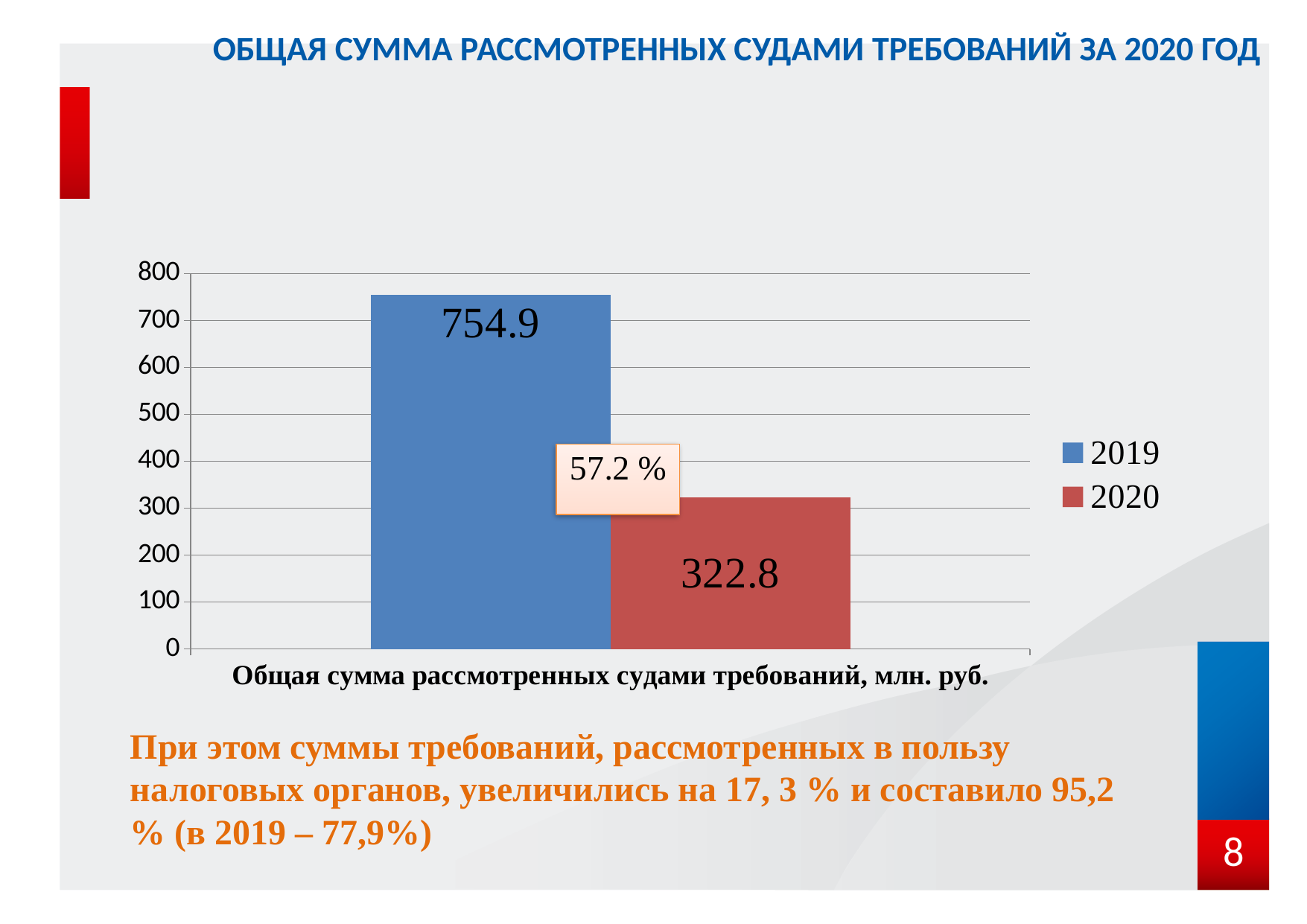
What percentage is shown in the callout box between the two bars? 57.2 % What kind of chart is shown on the slide? bar chart Is the value for 2019 greater or less than 700? greater How many series does the legend list? 2 What is the value for 2020 in the chart? 322.8 What is the maximum value shown on the vertical axis? 800 Which series has the lowest value in the chart? 2020 Which year has the higher value, 2019 or 2020? 2019 What colour is the bar for 2020? red What is the difference between the 2019 and 2020 values? 432.1 What is the value for 2019 in the chart? 754.9 Is the value for 2020 greater or less than 400? less